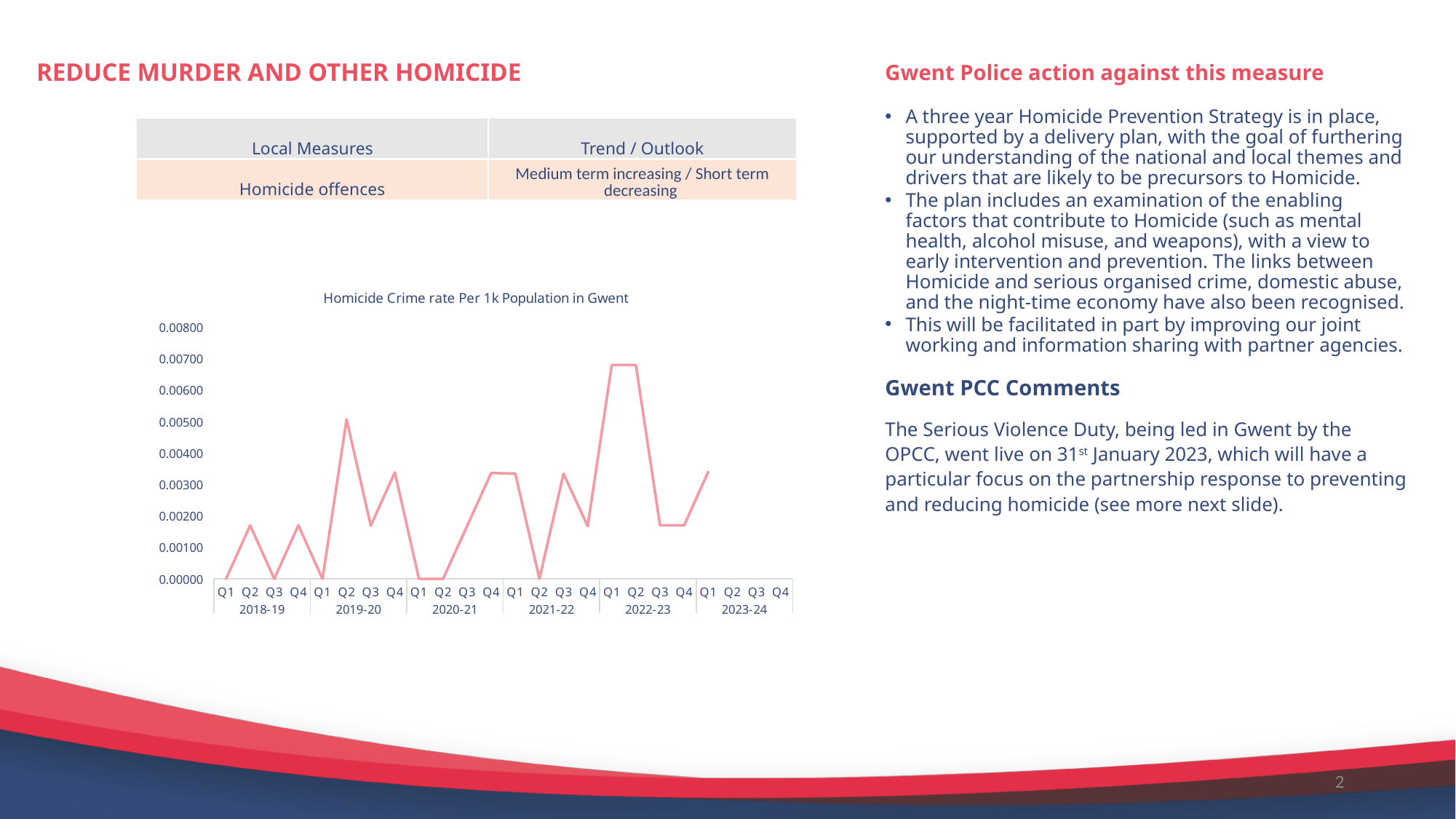
Is the value for Q2 2019-20 greater or less than 0.00400? greater Is the value for Q3 2022-23 greater or less than 0.00300? less What type of chart is shown on the slide? line chart How many financial years are labelled on the x axis? 6 What is the value for Q1 2020-21? 0.00000 Does the line rise or fall from Q2 2022-23 to Q3 2022-23? fall Is the value for Q1 2022-23 greater or less than 0.00600? greater What is the title of the chart? Homicide Crime rate Per 1k Population in Gwent Which is larger, the value for Q2 2019-20 or the value for Q4 2019-20? Q2 2019-20 What is the value for Q2 2021-22? 0.00000 In which financial year does the line reach its highest point? 2022-23 What is the value for Q1 2018-19? 0.00000